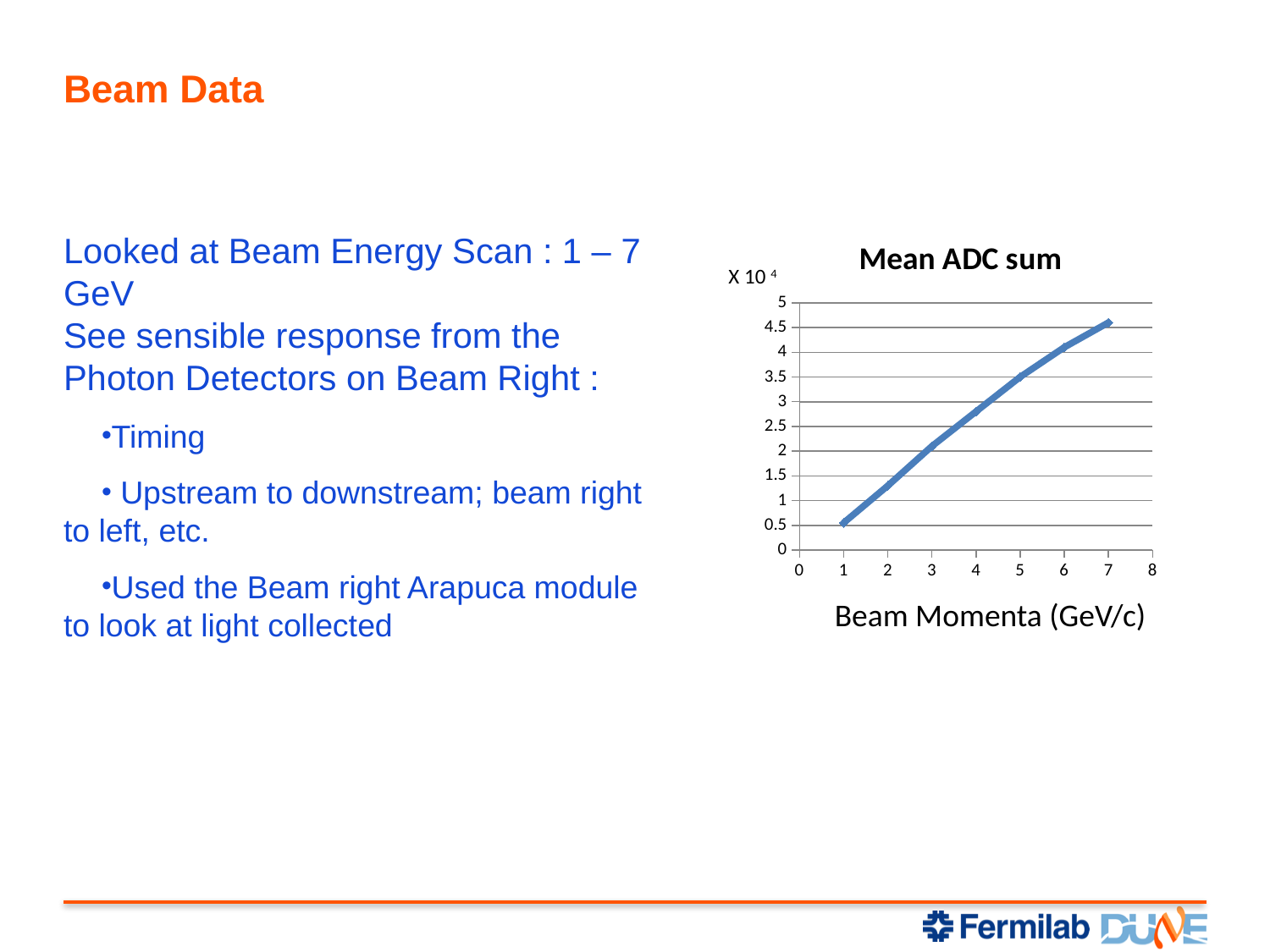
Is the Mean ADC sum at a beam momentum of 5 GeV/c greater or less than 3? greater Is the Mean ADC sum at a beam momentum of 1 GeV/c greater or less than 1? less Is the Mean ADC sum at a beam momentum of 7 GeV/c greater or less than 4? greater What is the title of the chart? Mean ADC sum What kind of chart is shown on the slide? line chart How many data points are plotted on the chart? 7 At which beam momentum is the Mean ADC sum highest? 7 What is the label of the x axis of the chart? Beam Momenta (GeV/c) Which has the larger Mean ADC sum: a beam momentum of 3 GeV/c or 6 GeV/c? 6 GeV/c Does the Mean ADC sum rise or fall as beam momentum increases along the x axis? rise At which beam momentum is the Mean ADC sum lowest? 1